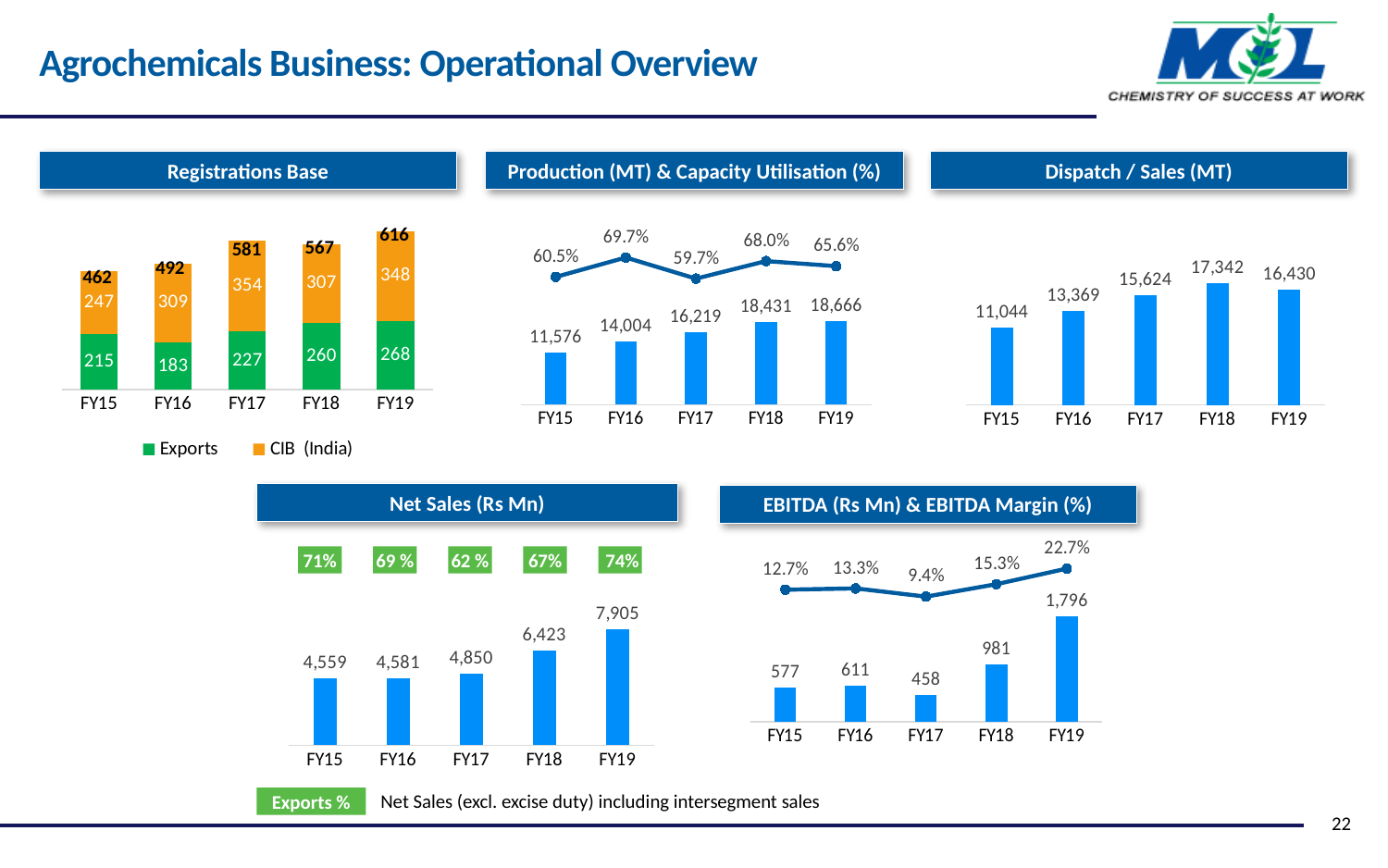
How many fiscal years are shown in the Dispatch / Sales (MT) chart? 5 In the Dispatch / Sales (MT) chart, which fiscal year has the highest value? FY18 In the Production (MT) & Capacity Utilisation (%) chart, what is the production for FY17? 16,219 In the Registrations Base chart, what is the Exports value for FY17? 227 In the Net Sales (Rs Mn) chart, what is the Exports % for FY17? 62 % In the Registrations Base chart, how many series does the legend list? 2 In the Production (MT) & Capacity Utilisation (%) chart, which fiscal year has the highest capacity utilisation? FY16 In the Net Sales (Rs Mn) chart, what is the net sales value for FY19? 7,905 In the EBITDA (Rs Mn) & EBITDA Margin (%) chart, which fiscal year has the lowest EBITDA? FY17 In the Dispatch / Sales (MT) chart, what is the difference between FY18 and FY19? 912 In the EBITDA (Rs Mn) & EBITDA Margin (%) chart, what is the EBITDA margin for FY19? 22.7% In the Registrations Base chart, what is the total registrations for FY19? 616